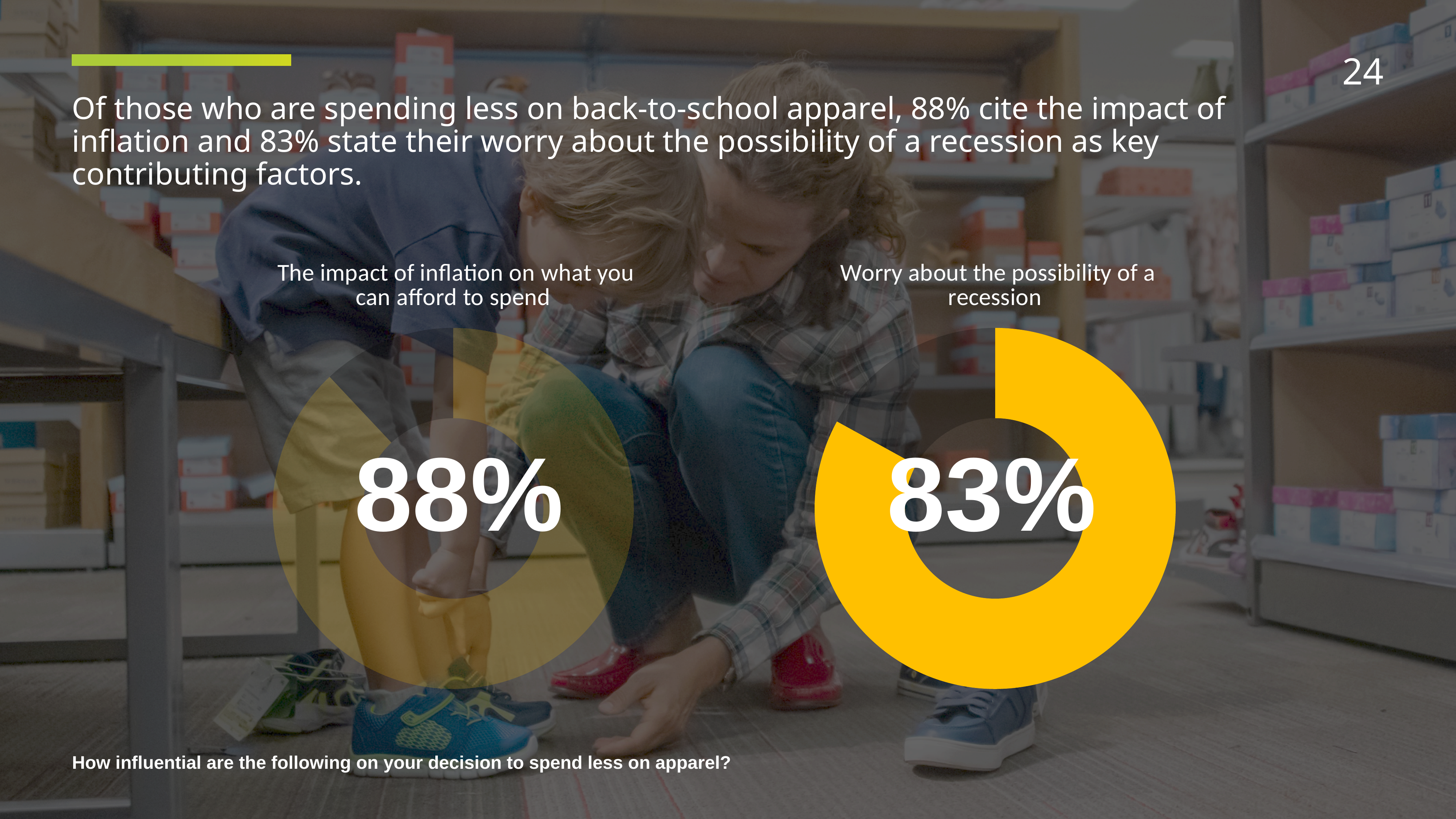
Is the value in the 'Worry about the possibility of a recession' chart larger or smaller than the value in the 'The impact of inflation on what you can afford to spend' chart? smaller In the chart titled 'Worry about the possibility of a recession', what percentage is shown? 83% How many donut charts are shown on the slide? 2 What survey question is shown at the bottom of the slide for these charts? How influential are the following on your decision to spend less on apparel? Which of the two charts on the slide shows the lower percentage? Worry about the possibility of a recession What kind of chart is used for 'The impact of inflation on what you can afford to spend'? Donut chart In the chart titled 'The impact of inflation on what you can afford to spend', what percentage is shown? 88% What is the difference between the percentage in the inflation chart and the percentage in the recession chart? 5% In the 'Worry about the possibility of a recession' chart, what share of the ring is filled? 83% What colour is the filled portion of the 'Worry about the possibility of a recession' donut chart? Yellow Which of the two charts on the slide shows the higher percentage? The impact of inflation on what you can afford to spend